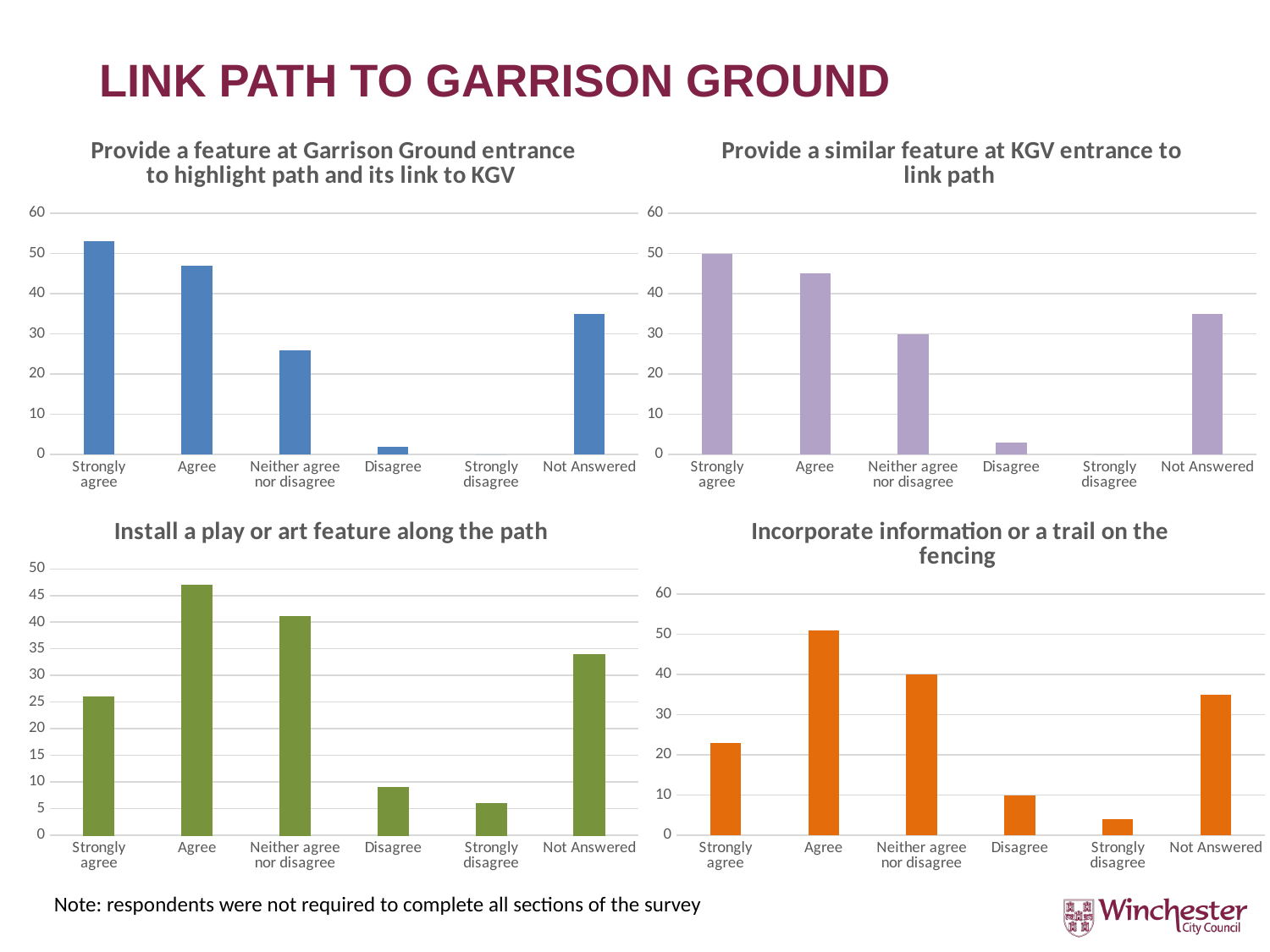
In the chart 'Install a play or art feature along the path', which is larger: Strongly agree or Not Answered? Not Answered In the chart 'Incorporate information or a trail on the fencing', what is the value for Neither agree nor disagree? 40 In the chart 'Provide a similar feature at KGV entrance to link path', what is the value for Strongly agree? 50 How many categories are shown on the x axis of the chart 'Incorporate information or a trail on the fencing'? 6 In the chart 'Provide a similar feature at KGV entrance to link path', what is the value for Neither agree nor disagree? 30 How many charts are shown on the slide? 4 What kind of chart is 'Install a play or art feature along the path'? bar chart In the chart 'Incorporate information or a trail on the fencing', what is the value for Disagree? 10 In the chart 'Install a play or art feature along the path', which category has the highest value? Agree In the chart 'Provide a feature at Garrison Ground entrance to highlight path and its link to KGV', which category has the highest value? Strongly agree In the chart 'Provide a feature at Garrison Ground entrance to highlight path and its link to KGV', is the value for Strongly agree greater or less than 50? greater In the chart 'Incorporate information or a trail on the fencing', which category has the lowest value? Strongly disagree